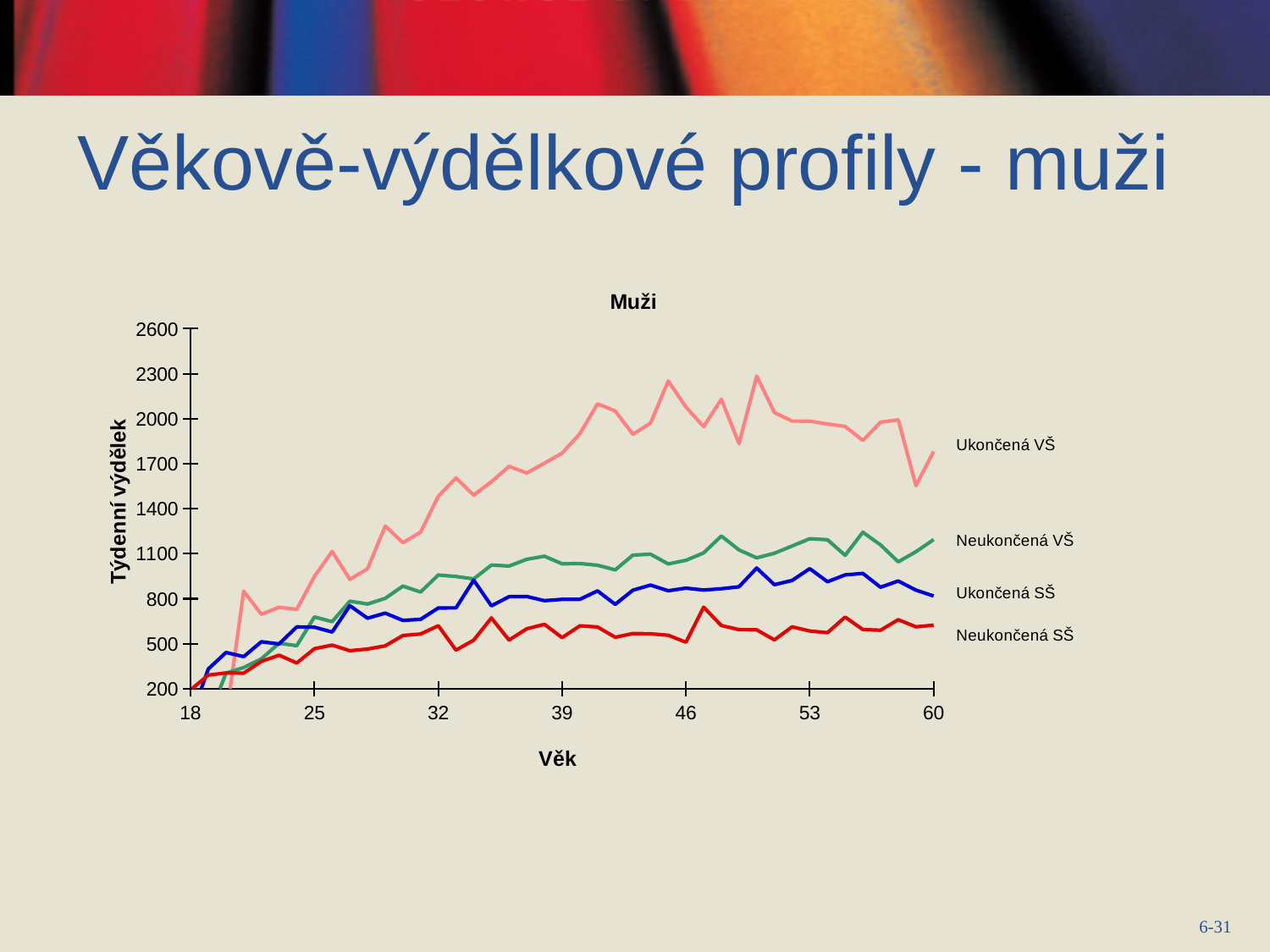
Which series has the highest value at age 60? Ukončená VŠ How many series are plotted in the chart? 4 Does the Ukončená VŠ series rise or fall between age 18 and age 39? rises Which series has the lowest value at age 60? Neukončená SŠ At age 32, which series has the larger value: Ukončená VŠ or Neukončená SŠ? Ukončená VŠ What is the label of the vertical axis? Týdenní výdělek Is the value for Ukončená VŠ at age 46 greater or less than 1700? greater Is the value for Ukončená SŠ at age 60 greater or less than 1100? less At age 53, which series has the larger value: Neukončená VŠ or Ukončená SŠ? Neukončená VŠ What is the title of the chart? Muži What kind of chart is shown on the slide? line chart Is the value for Neukončená SŠ at age 39 greater or less than 800? less